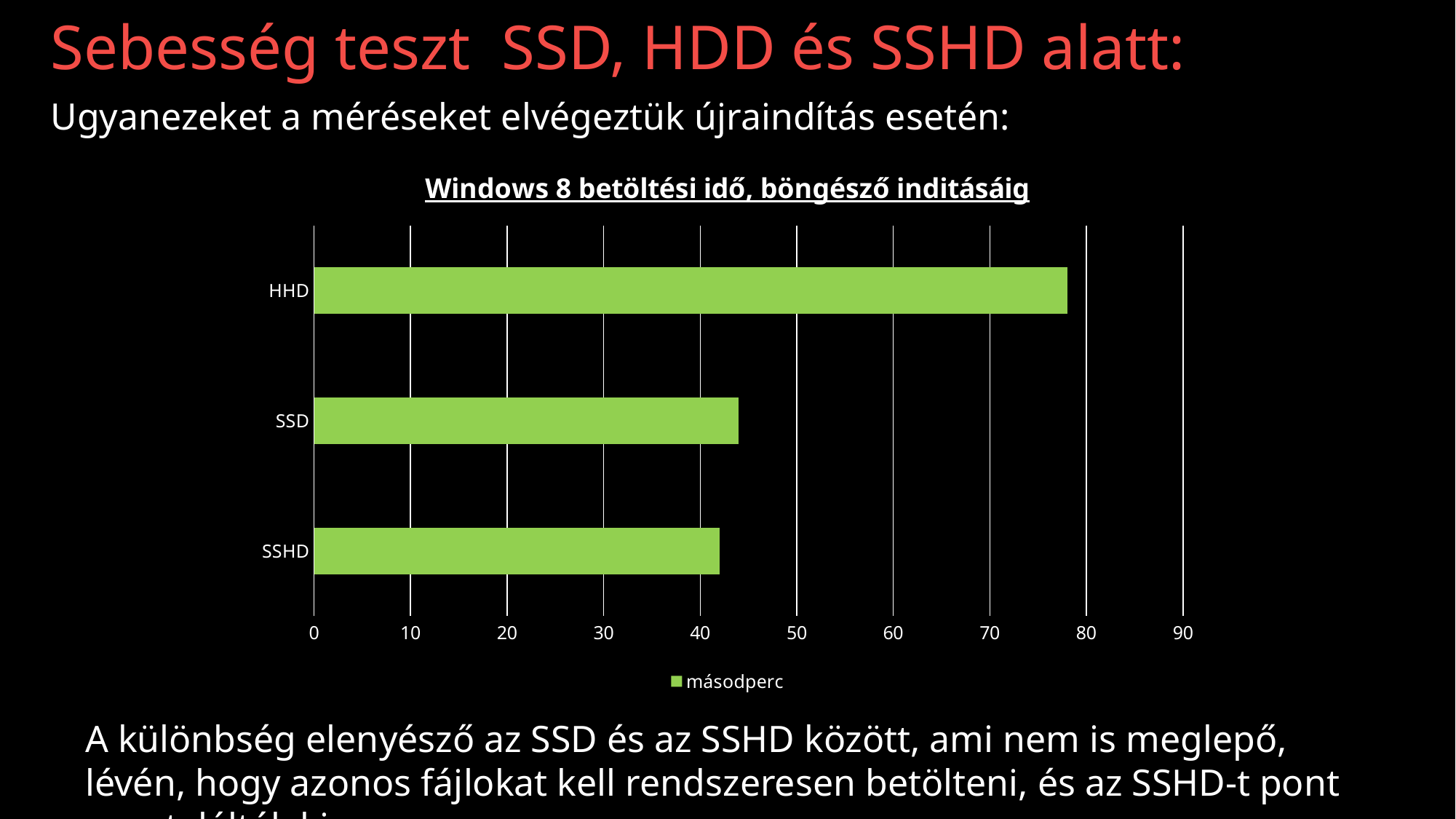
How many series does the legend list? 1 Is the value for HHD greater or less than 70? greater Which is larger, the value for HHD or the value for SSD? HHD What is the title of the chart? Windows 8 betöltési idő, böngésző inditásáig What is the name of the series shown in the legend? másodperc Is the value for SSHD greater or less than 50? less What kind of chart is shown on the slide? bar chart Is the value for SSD greater or less than 50? less Which category has the highest value? HHD How many categories are plotted in the chart? 3